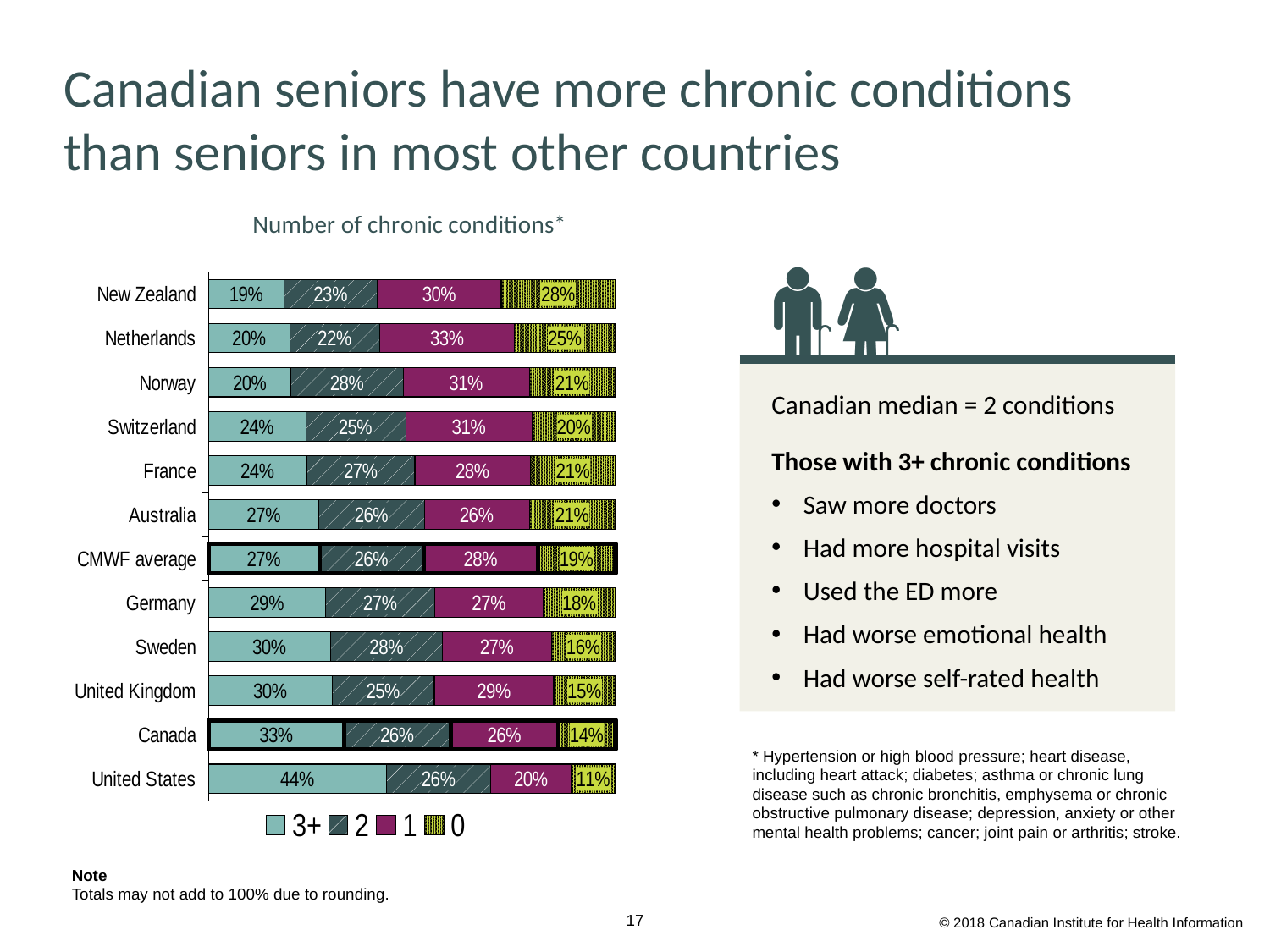
What type of chart is shown on the slide? Stacked bar chart What is the total of the labelled segments in the Canada bar? 99% What percentage of seniors in the United States have 3+ chronic conditions? 44% What percentage of seniors in Germany have 2 chronic conditions? 27% Which has a larger share of seniors with 3+ chronic conditions, Sweden or Switzerland? Sweden Which country has the highest share of seniors with 3+ chronic conditions? United States What percentage of Canadian seniors have 3+ chronic conditions? 33% How many series does the chart legend list? 4 Which country has the lowest share of seniors with 3+ chronic conditions? New Zealand How many countries or groups are listed on the chart? 12 How many percentage points higher is Canada's 3+ chronic conditions share than the CMWF average? 6 percentage points What percentage of seniors in New Zealand have 0 chronic conditions? 28%